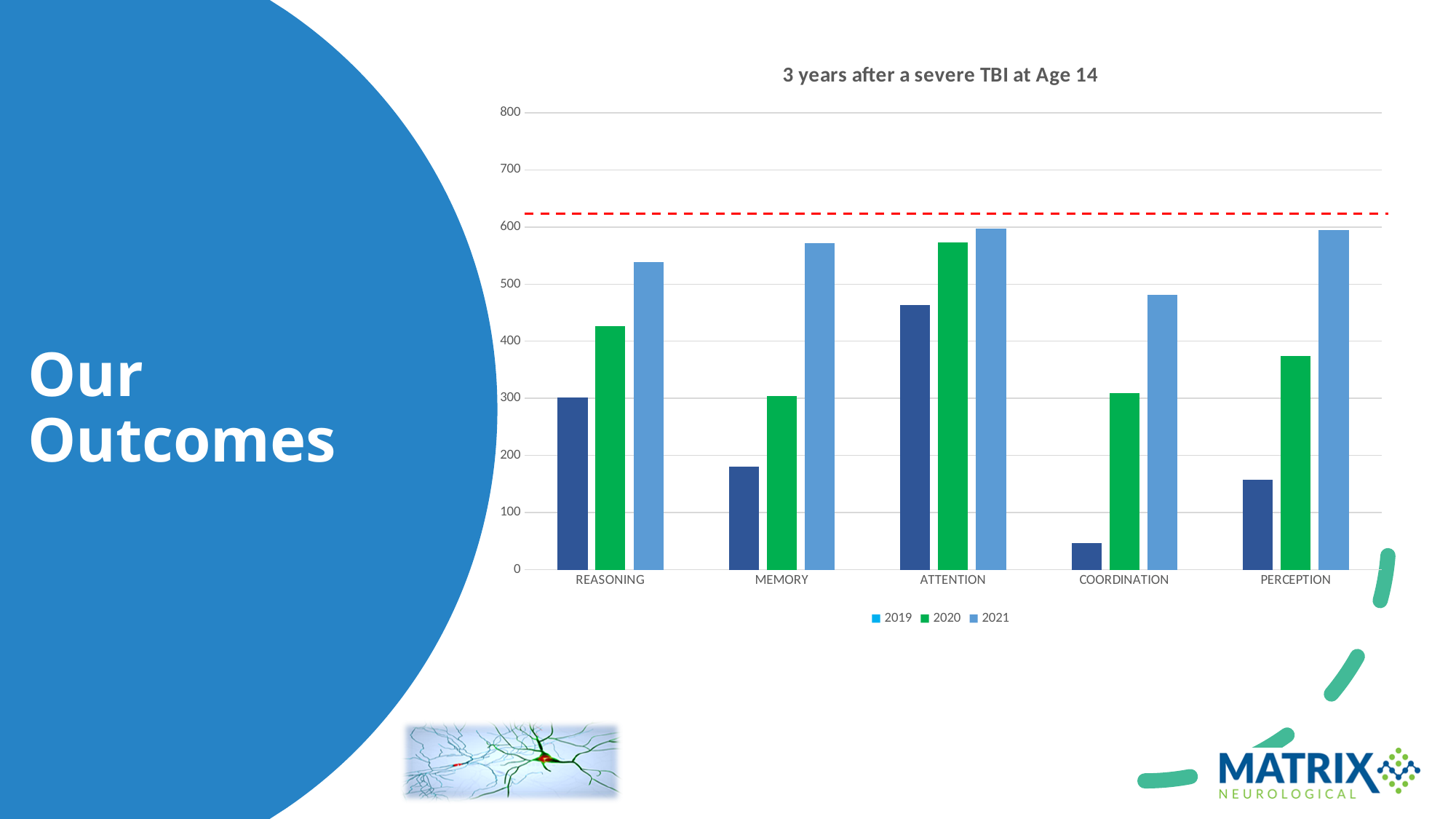
How many categories are shown on the x axis? 5 Within each category, do the values rise or fall from 2019 to 2021? rise What kind of chart is shown on the slide? bar chart Which is larger, the 2021 value for Coordination or the 2021 value for Perception? Perception Is the 2019 value for Coordination greater or less than 100? less How many series does the legend list? 3 Which category has the lowest value for the 2019 series? Coordination What is the title of the chart? 3 years after a severe TBI at Age 14 Which category has the highest value for the 2019 series? Attention Is the 2019 value for Perception greater or less than 200? less Is the 2021 value for Memory greater or less than 500? greater Which category has the highest value for the 2020 series? Attention